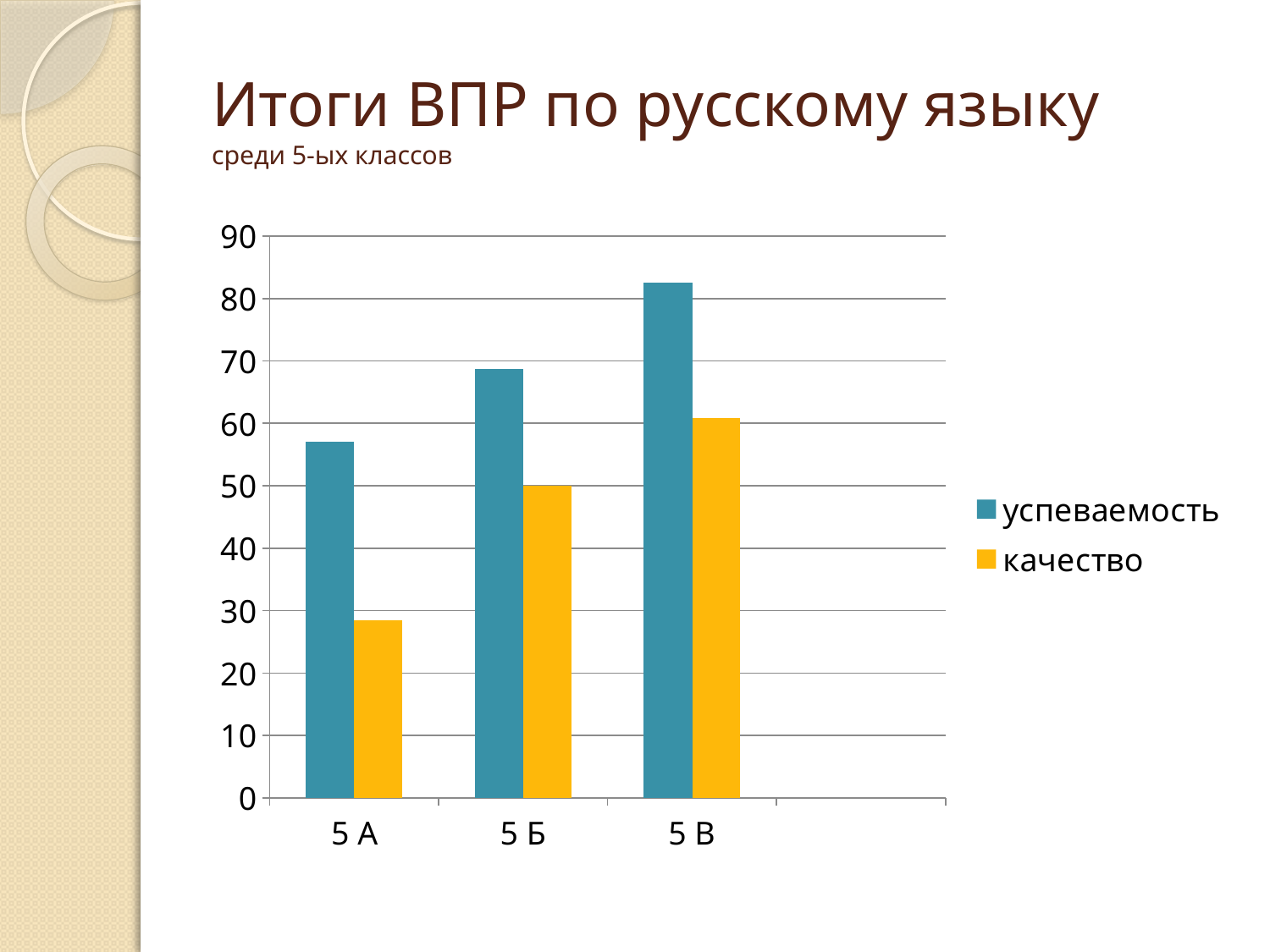
Which class has the lowest качество value? 5 А Which class has the highest успеваемость value? 5 В How many series does the legend list? 2 Is the качество value for 5 А greater or less than 30? less Which is larger: успеваемость for 5 Б or успеваемость for 5 В? 5 В Is the успеваемость value for 5 В greater or less than 80? greater Do the успеваемость values rise or fall from 5 А to 5 В? rise What are the two series named in the legend? успеваемость and качество Is the успеваемость value for 5 А greater or less than 50? greater What kind of chart is shown on the slide? bar chart How many classes are shown on the x axis? 3